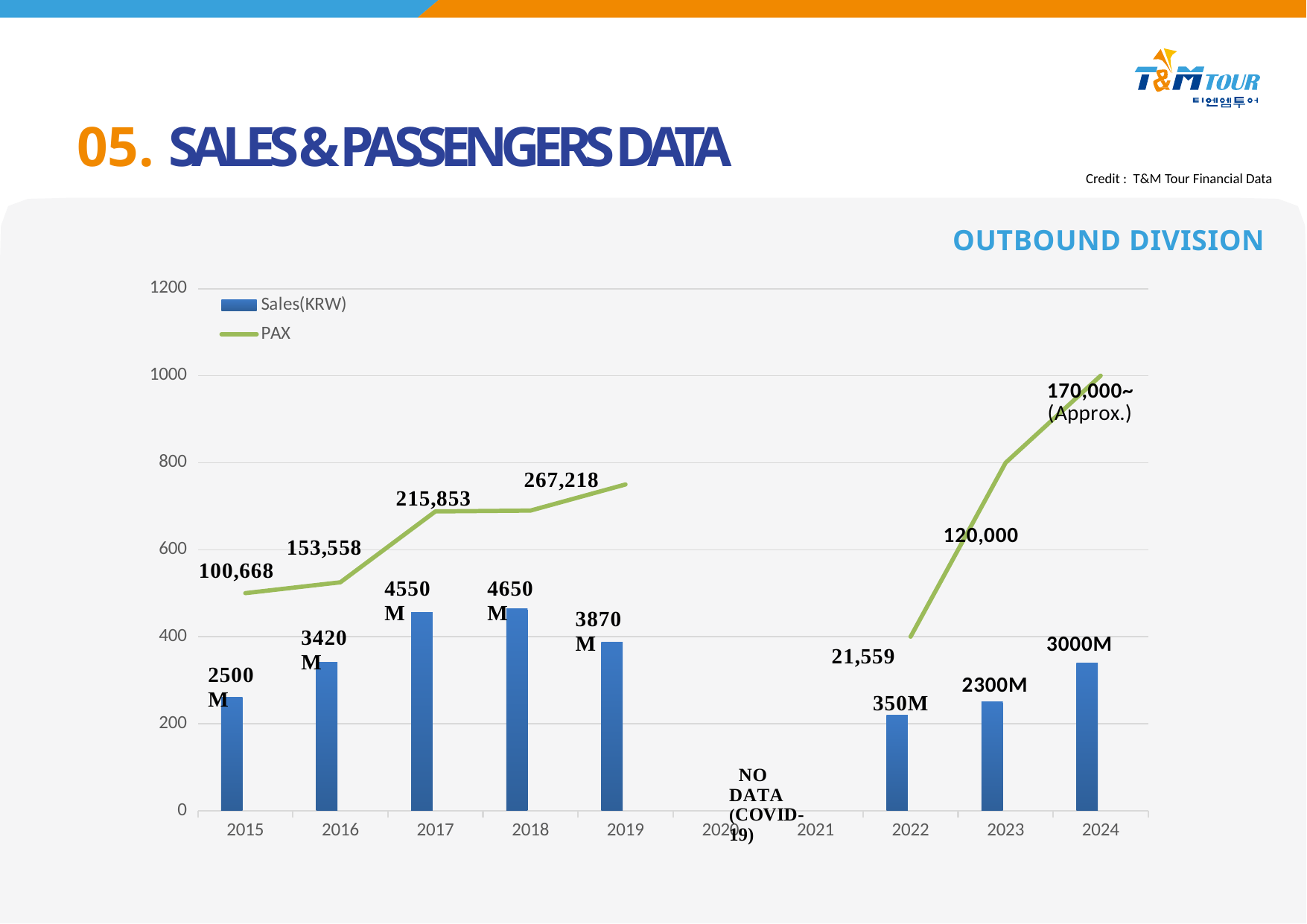
What reason is given on the chart for the missing data in 2020 and 2021? NO DATA (COVID-19) What is the PAX value for 2015? 100,668 Does the PAX line rise or fall from 2022 to 2024? rise How many series does the legend list? 2 What is the Sales(KRW) value for 2022? 350M Which year with a plotted bar has the lowest Sales(KRW) value? 2022 Which year has the larger Sales(KRW) value, 2023 or 2024? 2024 What is the Sales(KRW) value for 2018? 4650M What is the PAX value for 2023? 120,000 How many years are shown on the x axis? 10 What is the difference between the Sales(KRW) values for 2018 and 2017? 100M Which year has the highest Sales(KRW) value? 2018